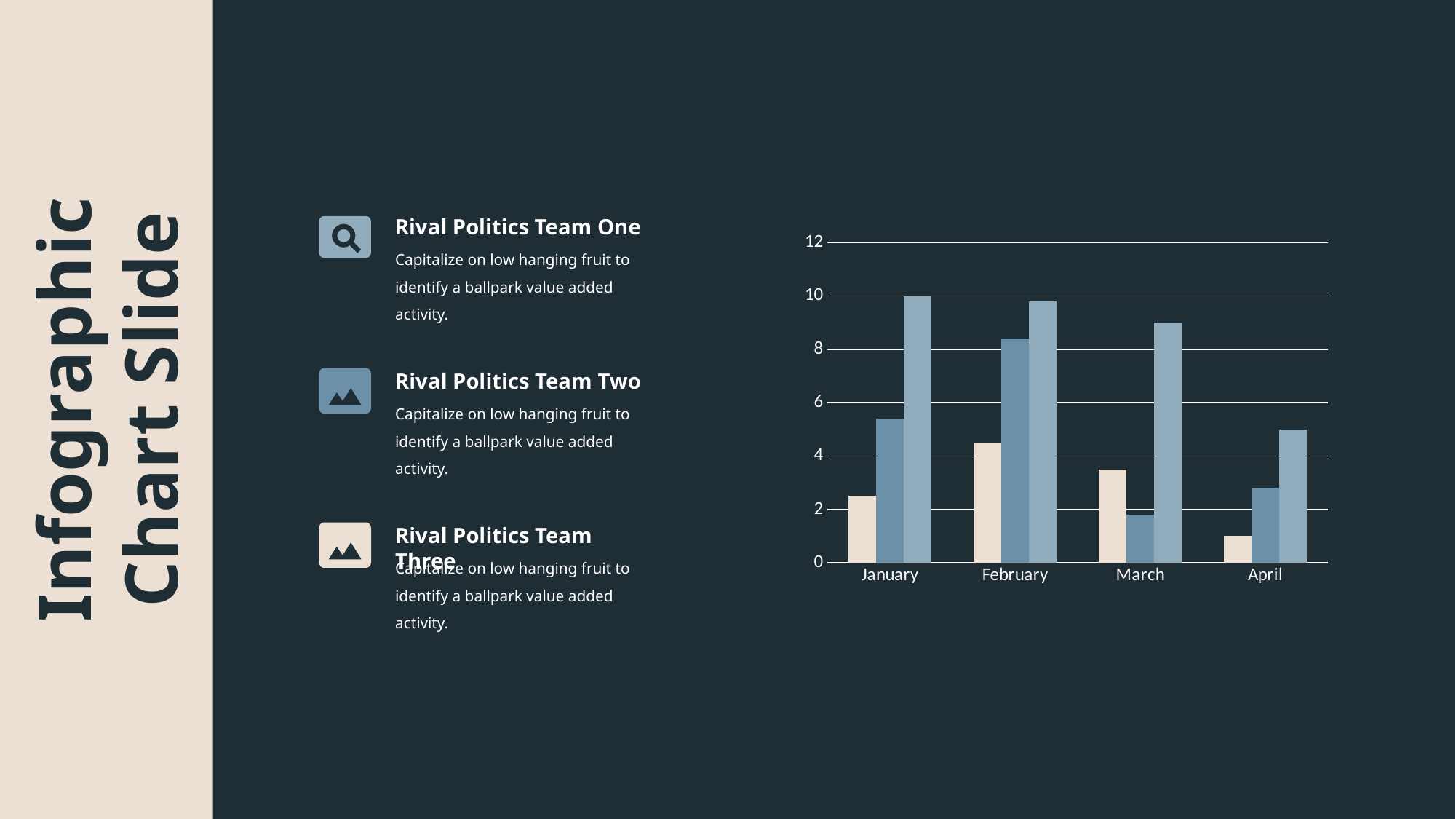
Which month has the tallest bar in the chart? January How many bars are plotted for each month in the chart? 3 Is the value of the tallest bar for March greater or less than 8? greater Which month has the shortest bar in the chart? April How many categories are shown on the x axis of the chart? 4 Is the value of the middle (medium blue) bar for March greater or less than 4? less Is the value of the beige (first) bar for February greater or less than 4? greater What is the highest value shown on the y axis of the chart? 12 What kind of chart is shown on the slide? bar chart Which is larger, the middle (medium blue) bar for January or the middle bar for February? February Which is larger, the light blue (third) bar for March or the light blue bar for April? March